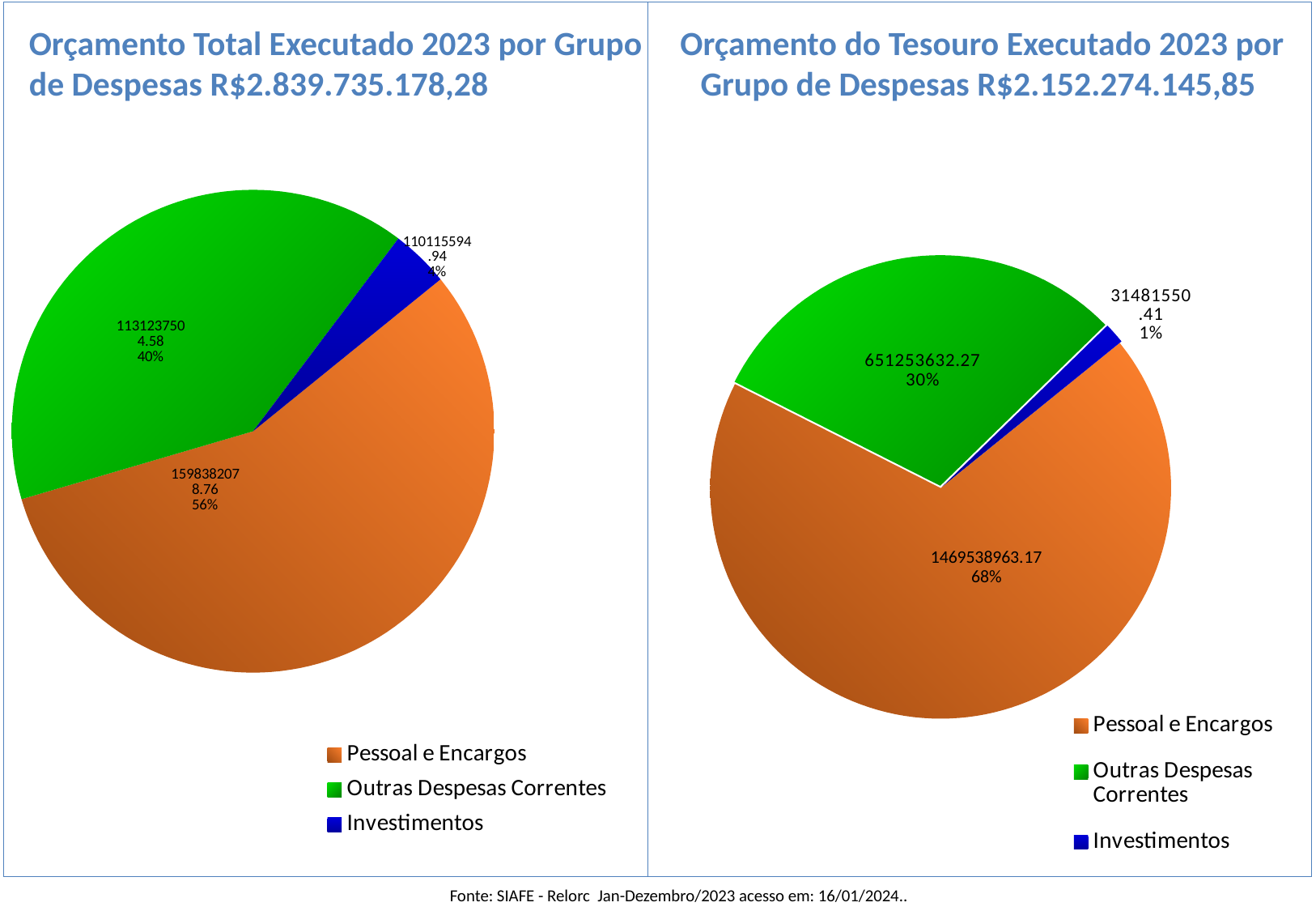
How many categories does the legend of the right chart (Orçamento do Tesouro Executado 2023) list? 3 What kind of chart is used in the 'Orçamento Total Executado 2023' chart on the left? Pie chart In the left chart (Orçamento Total Executado 2023), which group of expenses has the smallest slice? Investimentos In the right chart (Orçamento do Tesouro Executado 2023), what is the value shown for Investimentos? 31481550.41 In the right chart (Orçamento do Tesouro Executado 2023), what share of the pie is Investimentos? 1% In the right chart (Orçamento do Tesouro Executado 2023), what is the value shown for Outras Despesas Correntes? 651253632.27 In the left chart (Orçamento Total Executado 2023), what share of the pie is Pessoal e Encargos? 56% In the left chart (Orçamento Total Executado 2023), what share of the pie is Outras Despesas Correntes? 40% In the left chart (Orçamento Total Executado 2023), which group of expenses has the largest slice? Pessoal e Encargos In the left chart (Orçamento Total Executado 2023), what colour is the Investimentos slice? Blue In the right chart (Orçamento do Tesouro Executado 2023), which is larger, Pessoal e Encargos or Outras Despesas Correntes? Pessoal e Encargos